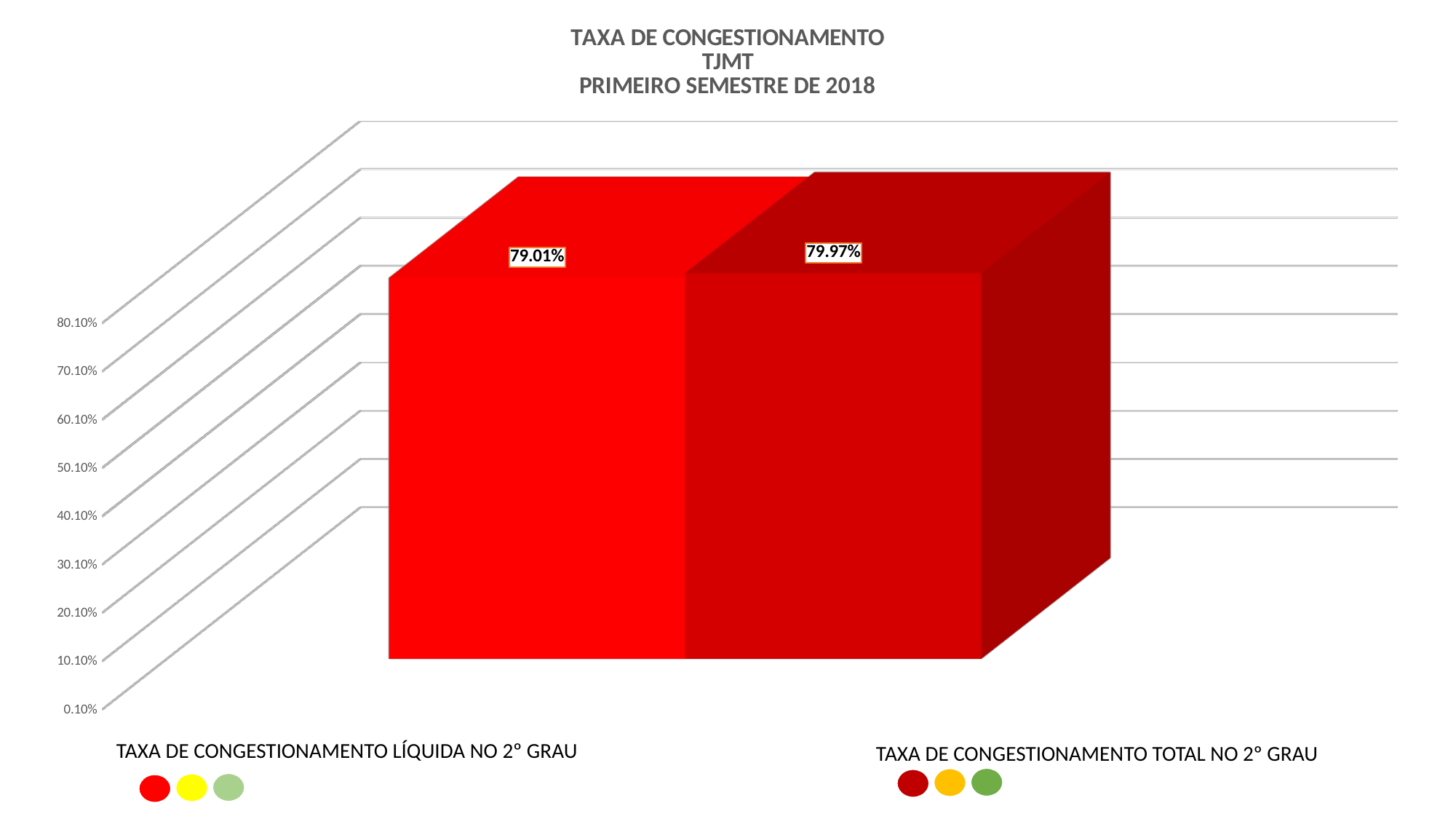
What is the lowest tick label shown on the vertical axis? 0.10% Is the value for TAXA DE CONGESTIONAMENTO LÍQUIDA NO 2° GRAU greater or less than 70.10%? greater Which category has the highest value? TAXA DE CONGESTIONAMENTO TOTAL NO 2° GRAU Which category has the lowest value? TAXA DE CONGESTIONAMENTO LÍQUIDA NO 2° GRAU Which is larger, the value for TAXA DE CONGESTIONAMENTO LÍQUIDA NO 2° GRAU or the value for TAXA DE CONGESTIONAMENTO TOTAL NO 2° GRAU? TAXA DE CONGESTIONAMENTO TOTAL NO 2° GRAU What is the value for TAXA DE CONGESTIONAMENTO TOTAL NO 2° GRAU? 79.97% What is the difference between the value for TAXA DE CONGESTIONAMENTO TOTAL NO 2° GRAU and the value for TAXA DE CONGESTIONAMENTO LÍQUIDA NO 2° GRAU? 0.96% What kind of chart is shown on the slide? bar chart How many bars are shown in the chart? 2 What is the title of the chart? TAXA DE CONGESTIONAMENTO TJMT PRIMEIRO SEMESTRE DE 2018 What is the value for TAXA DE CONGESTIONAMENTO LÍQUIDA NO 2° GRAU? 79.01% Is the value for TAXA DE CONGESTIONAMENTO TOTAL NO 2° GRAU greater or less than 80.10%? less